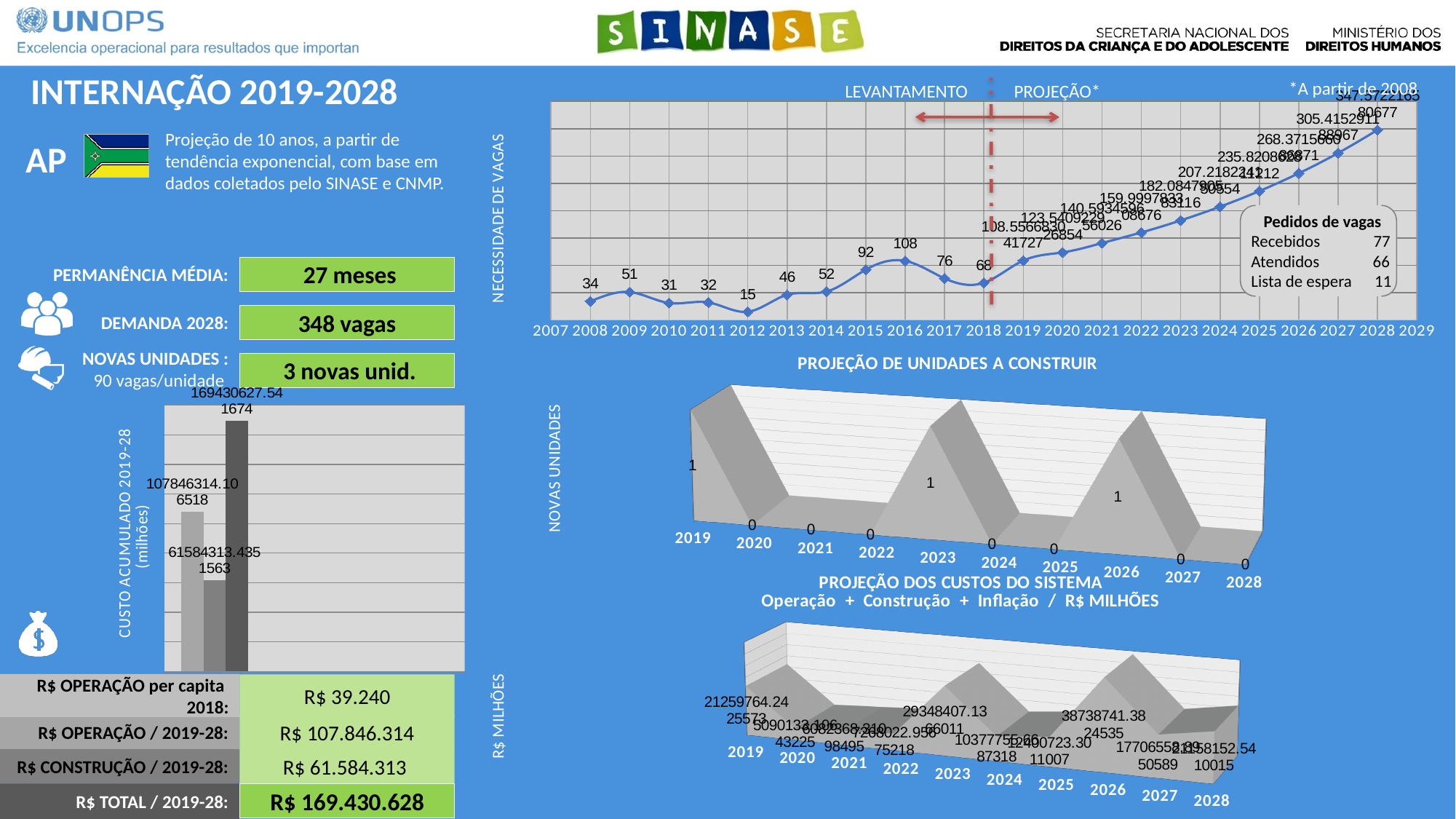
How many bars does the CUSTO ACUMULADO 2019-28 bar chart on the left show? 3 In the PROJEÇÃO DE UNIDADES A CONSTRUIR chart, what is the value for 2023? 1 In the NECESSIDADE DE VAGAS line chart, what is the value for 2016? 108 In the NECESSIDADE DE VAGAS line chart, which year has the highest value? 2028 In the NECESSIDADE DE VAGAS line chart, what is the value for 2018? 68 What kind of chart is the NECESSIDADE DE VAGAS chart at the top right? line chart In the NECESSIDADE DE VAGAS line chart, which year has the larger value, 2014 or 2015? 2015 In the PROJEÇÃO DE UNIDADES A CONSTRUIR chart, how many years have a value of 1? 3 In the NECESSIDADE DE VAGAS line chart, what is the difference between the values for 2016 and 2017? 32 In the NECESSIDADE DE VAGAS line chart, which year has the lowest value? 2012 In the NECESSIDADE DE VAGAS line chart, what is the value for 2008? 34 In the PROJEÇÃO DE UNIDADES A CONSTRUIR chart, how many years are shown on the x axis? 10